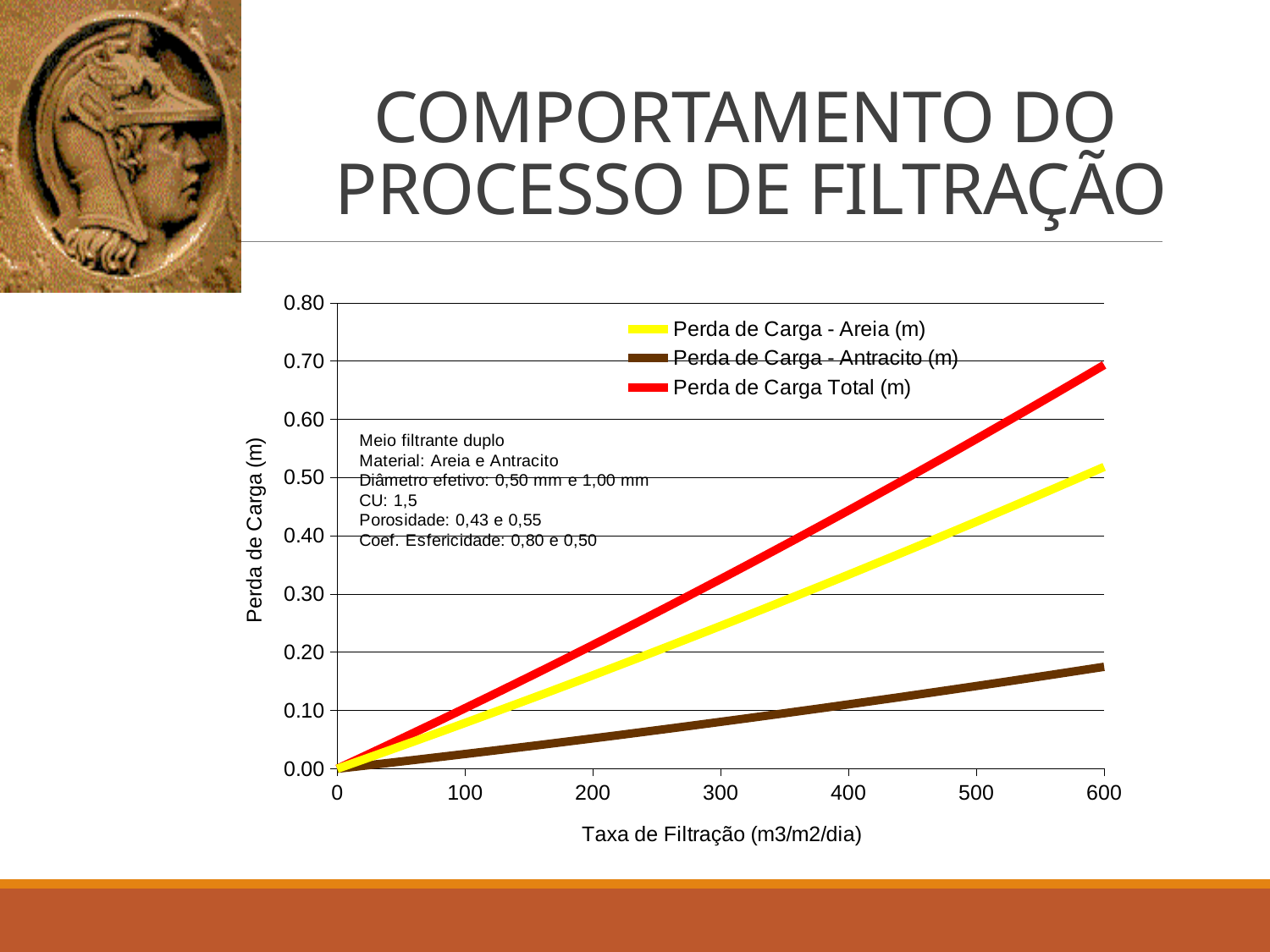
Is the value of Perda de Carga Total (m) at 300 m3/m2/dia greater or less than 0.30? greater Is the value of Perda de Carga - Antracito (m) at 600 m3/m2/dia greater or less than 0.20? less What colour is the line for Perda de Carga - Areia (m)? yellow Do the values of Perda de Carga Total (m) rise or fall as the filtration rate increases? rise Is the value of Perda de Carga - Areia (m) at 600 m3/m2/dia greater or less than 0.60? less Which is larger at 400 m3/m2/dia: Perda de Carga - Areia (m) or Perda de Carga - Antracito (m)? Perda de Carga - Areia (m) Which series has the highest value at a filtration rate of 600 m3/m2/dia? Perda de Carga Total (m) Which series has the lowest value at a filtration rate of 600 m3/m2/dia? Perda de Carga - Antracito (m) What kind of chart is shown on the slide? line chart How many series does the legend list? 3 What is the label of the x axis? Taxa de Filtração (m3/m2/dia)